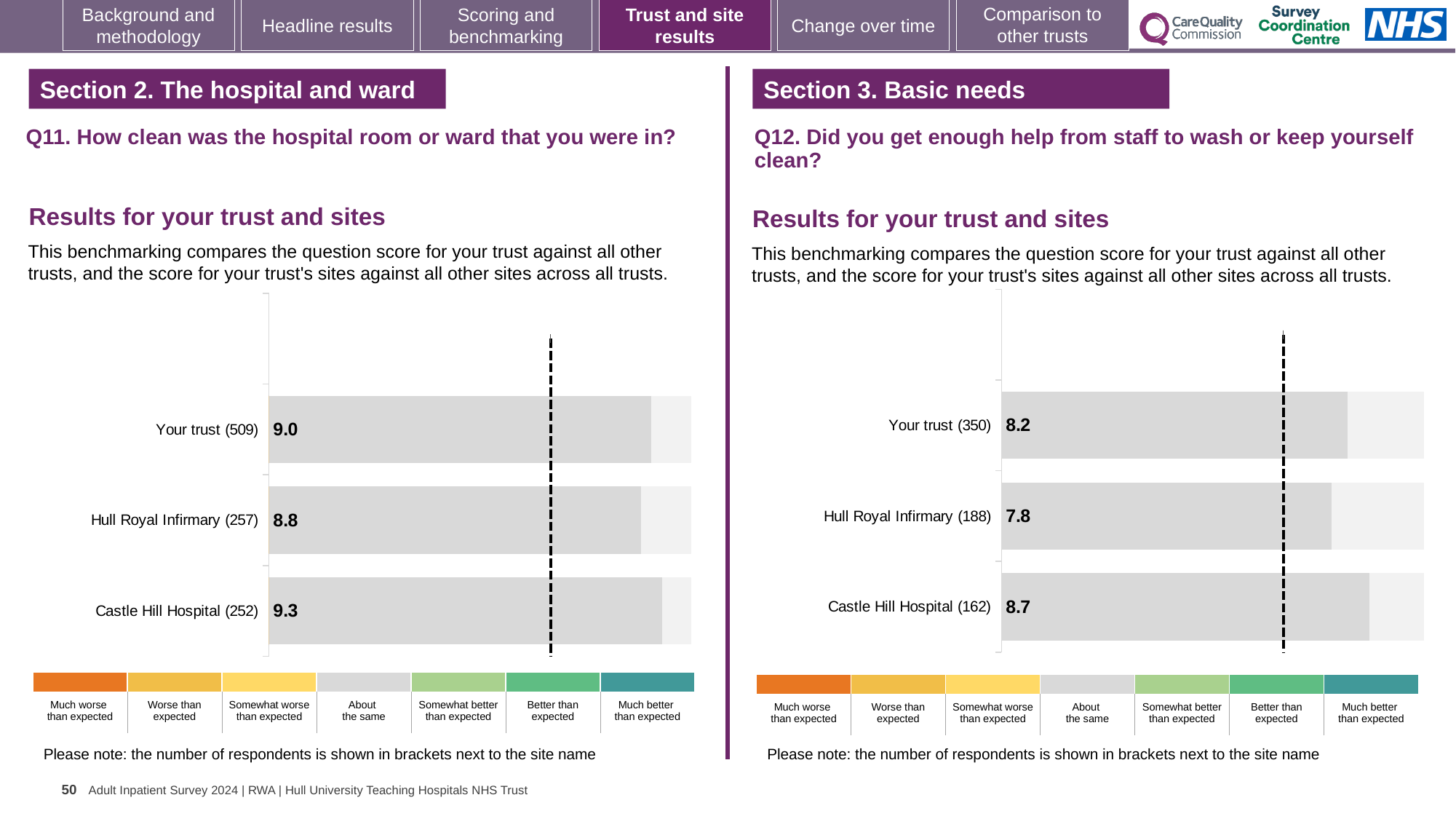
In the Q11 chart on the left, what is the score for Your trust? 9.0 In the Q12 chart on the right, which site or trust has the highest score? Castle Hill Hospital In the Q12 chart on the right, how many respondents are shown in brackets for Your trust? 350 In the Q11 chart on the left, what is the score for Castle Hill Hospital? 9.3 In the Q12 chart on the right, what is the difference between the scores for Castle Hill Hospital and Your trust? 0.5 In the Q11 chart on the left, which site or trust has the lowest score? Hull Royal Infirmary In the Q12 chart on the right, what is the score for Hull Royal Infirmary? 7.8 In the Q11 chart on the left, how many respondents are shown in brackets for Hull Royal Infirmary? 257 How many bars are plotted in the Q11 chart on the left? 3 In the Q11 chart on the left, what is the difference between the scores for Castle Hill Hospital and Hull Royal Infirmary? 0.5 In the Q12 chart on the right, is the score for Your trust or for Hull Royal Infirmary larger? Your trust What kind of chart is used for the Q12 results on the right? Bar chart